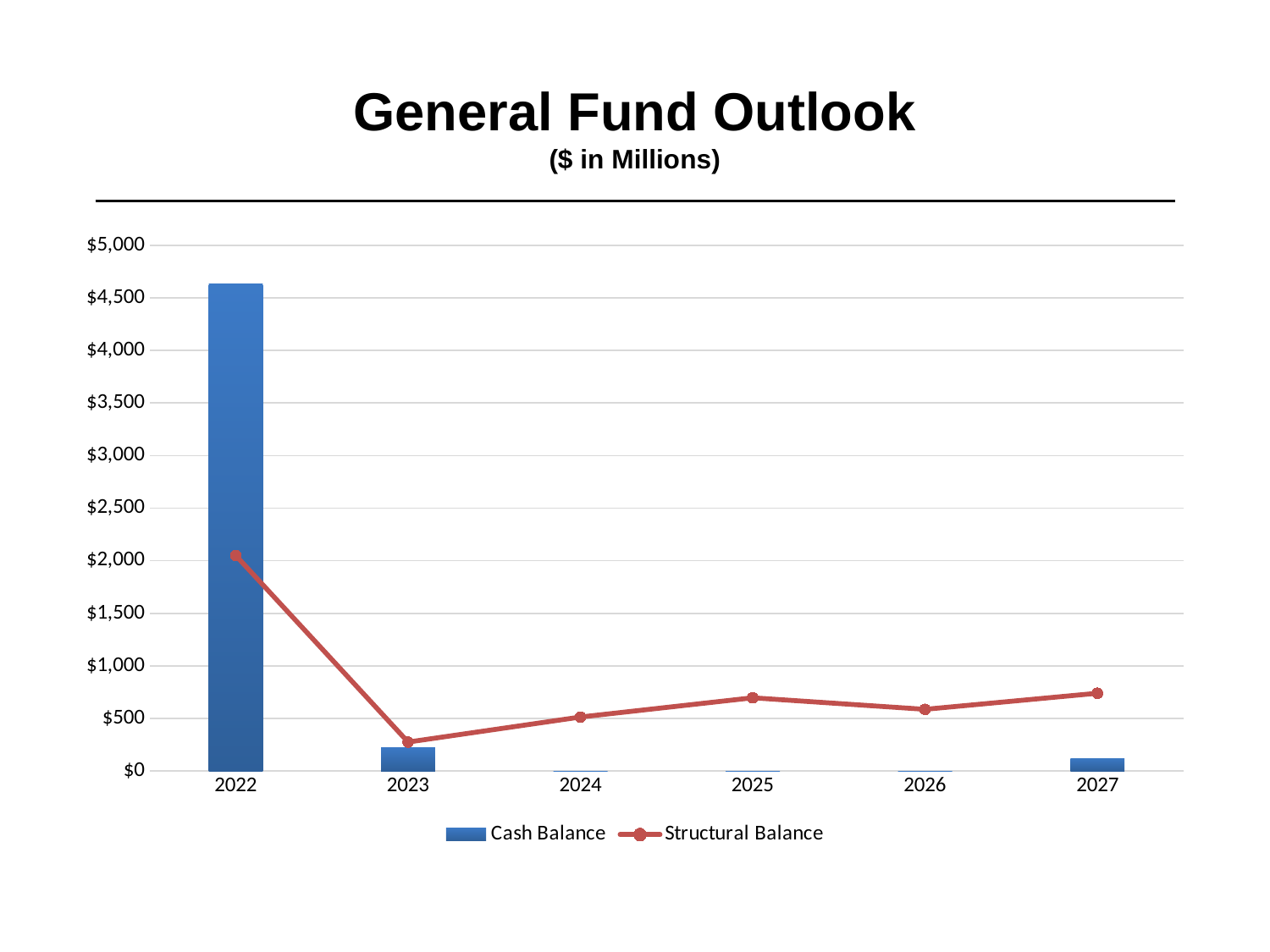
How many series does the legend list? 2 Which year has the highest Cash Balance? 2022 Does the Structural Balance rise or fall from 2023 to 2025? rise Which is larger, the Cash Balance for 2023 or for 2027? 2023 Is the Cash Balance for 2022 greater or less than $4,500? greater Is the Structural Balance for 2023 greater or less than $500? less Which year has the highest Structural Balance? 2022 Which is larger, the Structural Balance for 2024 or for 2025? 2025 Is the Structural Balance for 2022 greater or less than $1,500? greater What kind of chart is shown on the slide? A combination bar and line chart Which year has the lowest Structural Balance? 2023 How many years are shown on the x axis? 6